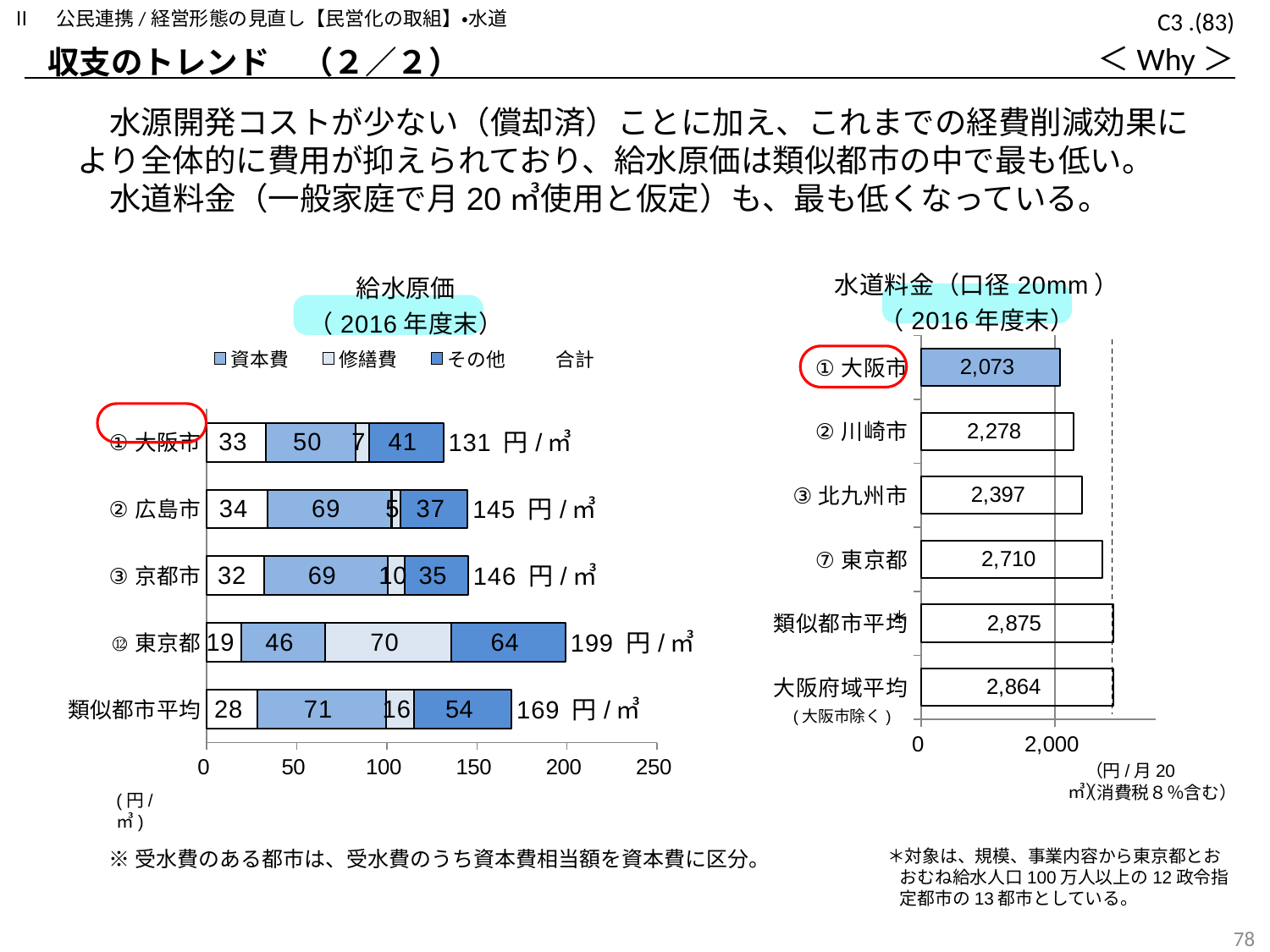
In the 給水原価 chart on the left, which has the larger total, ② 広島市 or ③ 京都市? ③ 京都市 How many categories are shown in the 水道料金（口径20mm） chart on the right? 6 In the 給水原価 chart on the left, what is the total (合計) for ① 大阪市? 131 円/㎥ In the 水道料金（口径20mm） chart on the right, which category has the lowest value? ① 大阪市 In the 給水原価 chart on the left, what is the difference between the totals for ⑫ 東京都 and ① 大阪市? 68 円/㎥ In the 給水原価 chart on the left, which category has the highest total? ⑫ 東京都 How many categories are shown in the 給水原価 chart on the left? 5 In the 給水原価 chart on the left, is the total for 類似都市平均 greater or less than 150? greater In the 水道料金（口径20mm） chart on the right, which category has the highest value? 類似都市平均 What kind of chart is the 水道料金（口径20mm） chart on the right? Bar chart In the 水道料金（口径20mm） chart on the right, what is the value for ① 大阪市? 2,073 In the 水道料金（口径20mm） chart on the right, what is the difference between ② 川崎市 and ① 大阪市? 205